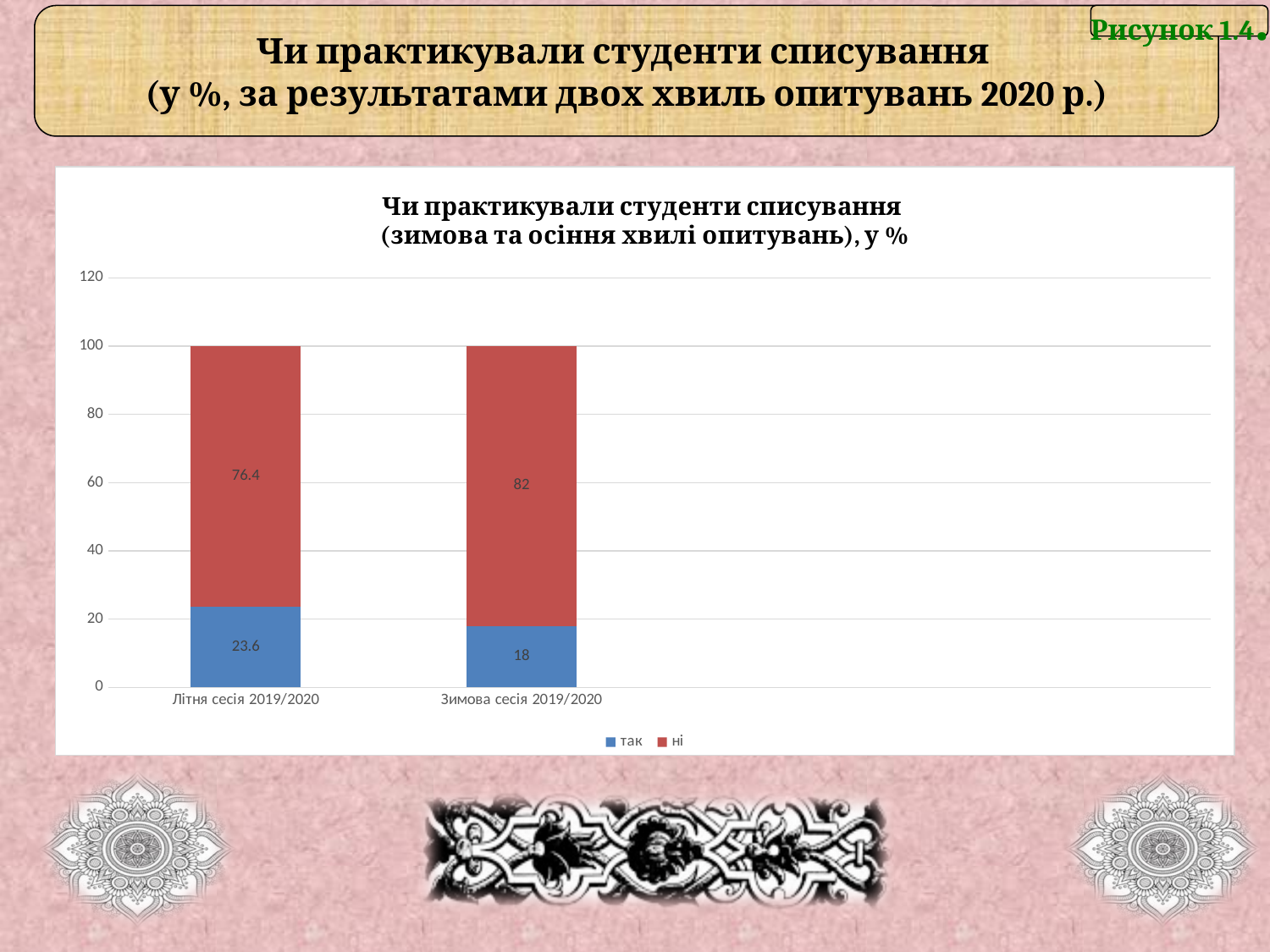
What is the total of the stacked bar for Зимова сесія 2019/2020? 100 Which category has the higher value for "так"? Літня сесія 2019/2020 Is the "так" value for Літня сесія 2019/2020 larger or smaller than the "так" value for Зимова сесія 2019/2020? larger What is the value for "так" in Зимова сесія 2019/2020? 18 Which category has the lower value for "ні"? Літня сесія 2019/2020 What is the value for "ні" in Зимова сесія 2019/2020? 82 What is the value for "так" in Літня сесія 2019/2020? 23.6 How many series does the legend list? 2 How many categories are shown on the x axis? 2 What is the difference between the "ні" values for Зимова сесія 2019/2020 and Літня сесія 2019/2020? 5.6 What is the value for "ні" in Літня сесія 2019/2020? 76.4 What kind of chart is shown? stacked bar chart